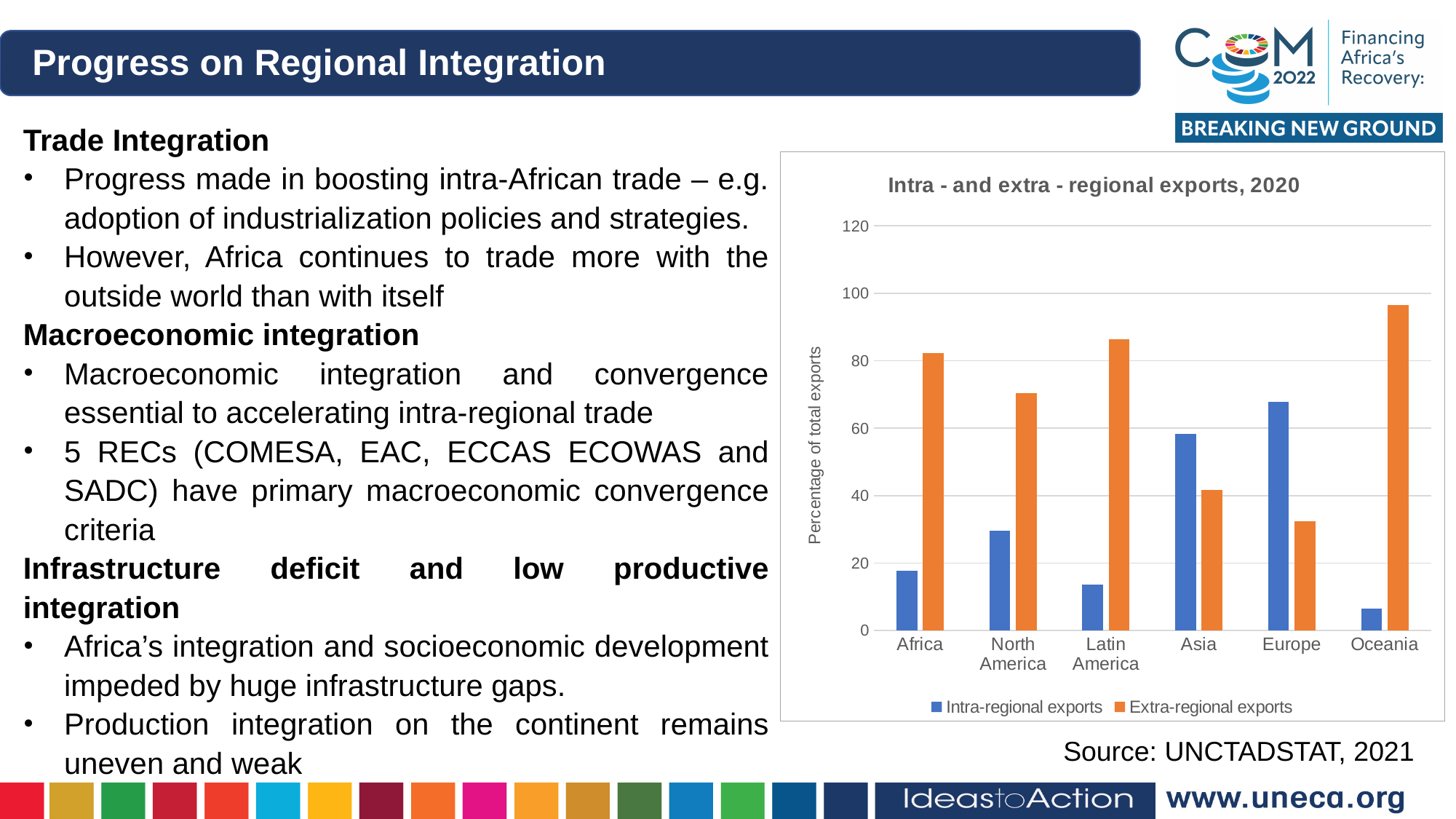
For Asia, which is larger: Intra-regional exports or Extra-regional exports? Intra-regional exports What type of chart is shown on the slide? Bar chart How many series does the chart legend list? 2 Which region has the highest value for Intra-regional exports? Europe What is the label of the y axis of the chart? Percentage of total exports What is the title of the chart? Intra - and extra - regional exports, 2020 Is the value for Extra-regional exports for Latin America greater or less than 80? greater Which region has the lowest value for Intra-regional exports? Oceania How many regions are shown on the x axis of the chart? 6 Is the value for Intra-regional exports for Africa greater or less than 20? less Which region has the highest value for Extra-regional exports? Oceania Which region has the lowest value for Extra-regional exports? Europe